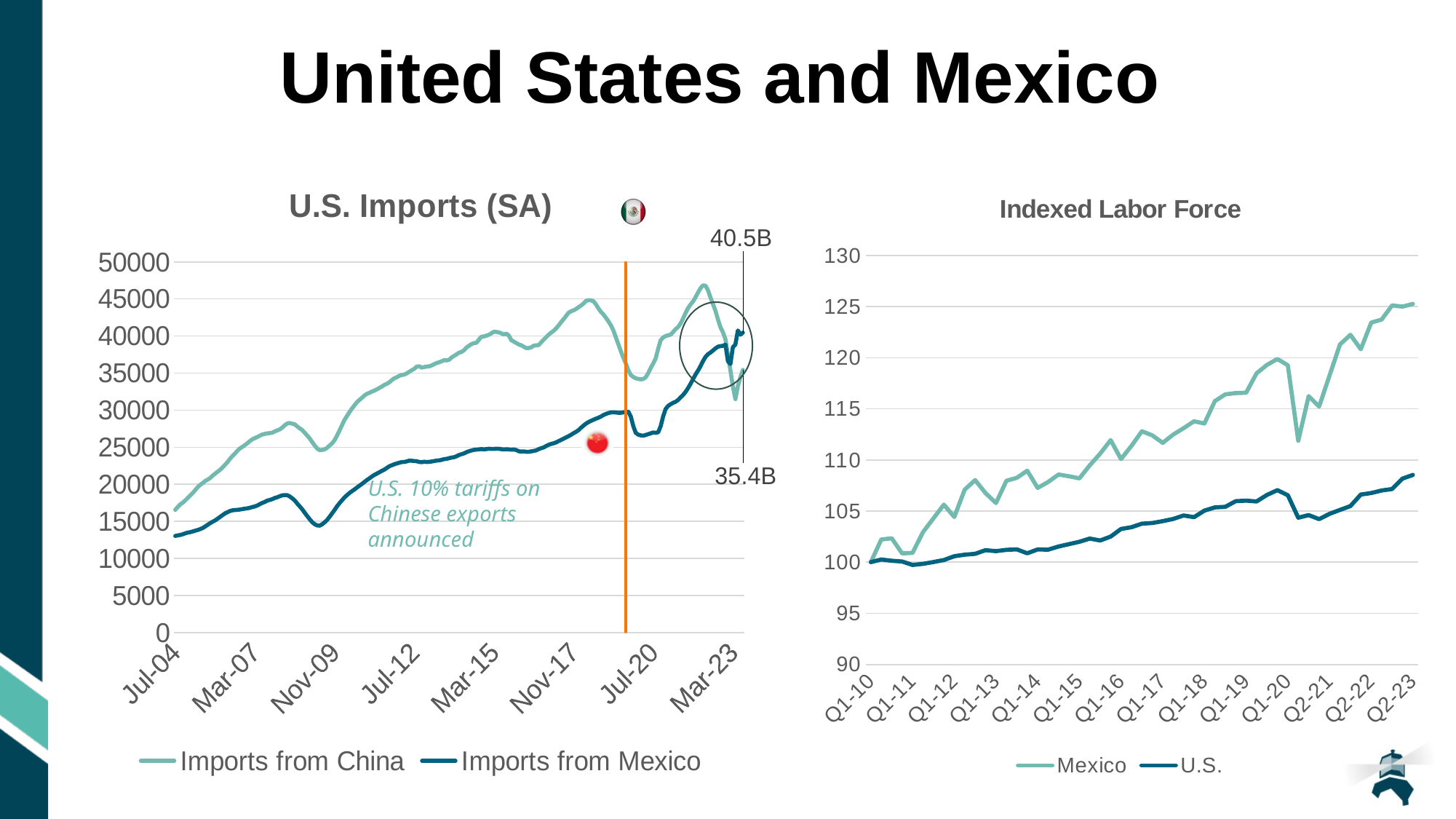
How many series does the legend of the 'Indexed Labor Force' chart list? 2 In the 'Indexed Labor Force' chart, is the value for U.S. at Q2-23 greater or less than 110? less What kind of chart is the 'U.S. Imports (SA)' chart? line chart In the 'U.S. Imports (SA)' chart, is the value for Imports from Mexico at Jul-04 greater or less than 15000? less How many series does the legend of the 'U.S. Imports (SA)' chart list? 2 In the 'Indexed Labor Force' chart, is the value for Mexico at Q2-23 greater or less than 120? greater What is the title of the chart on the right side of the slide? Indexed Labor Force In the 'U.S. Imports (SA)' chart, which series is higher at Jul-12: Imports from China or Imports from Mexico? Imports from China In the 'Indexed Labor Force' chart, which series is higher at Q2-23: Mexico or U.S.? Mexico In the 'U.S. Imports (SA)' chart, what event does the text annotation near the orange vertical line describe? U.S. 10% tariffs on Chinese exports announced In the 'Indexed Labor Force' chart, does the U.S. series generally rise or fall from Q1-10 to Q2-23? rise